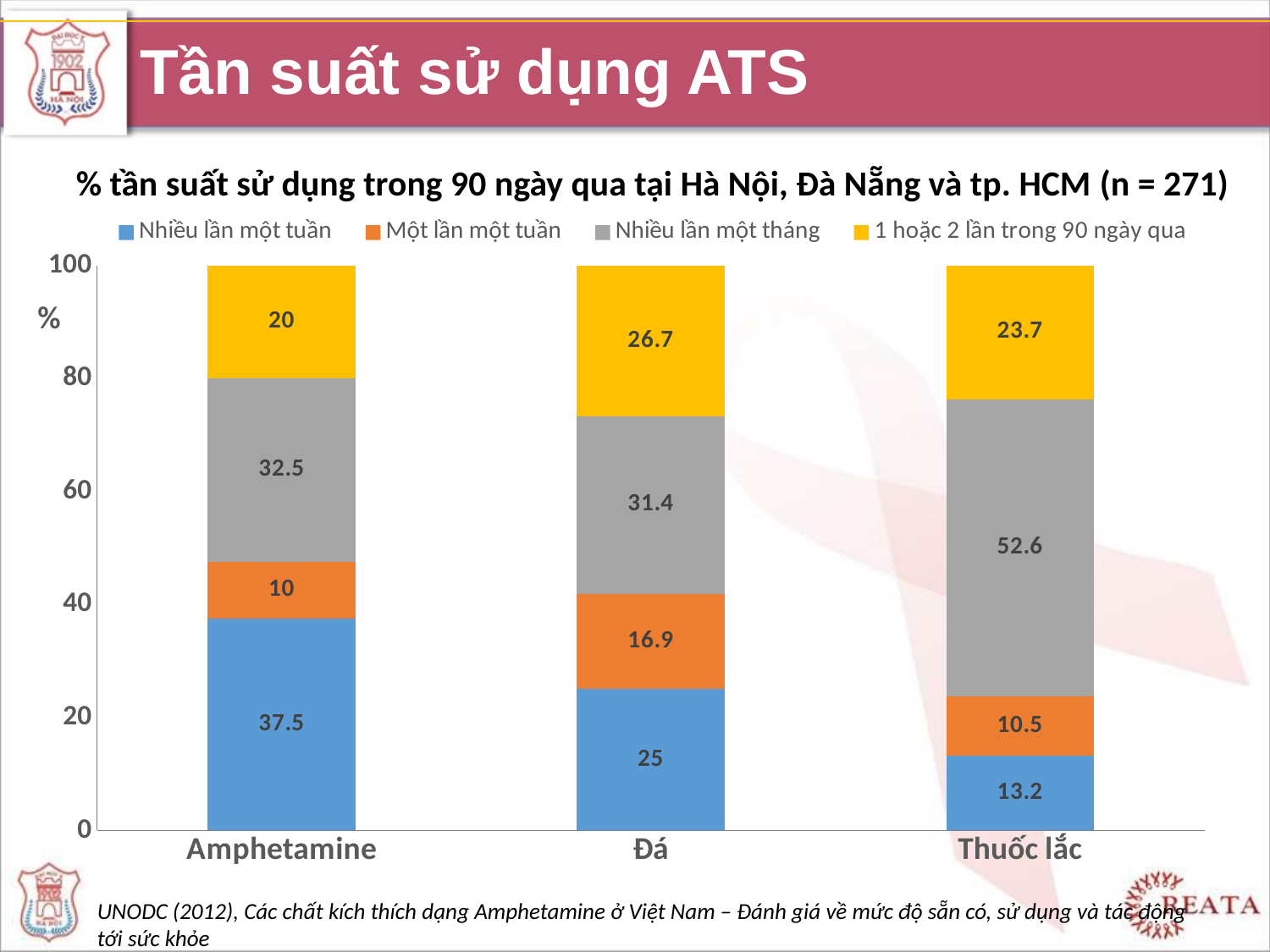
How many series does the legend list? 4 What is the value of "Nhiều lần một tuần" for Amphetamine? 37.5 Which category has the lowest value for "Nhiều lần một tháng"? Đá How many categories are shown on the x axis? 3 What is the value of "1 hoặc 2 lần trong 90 ngày qua" for Đá? 26.7 What is the total of the stacked bar for Đá? 100 Which is larger: "Một lần một tuần" for Đá or for Amphetamine? Đá What kind of chart is shown on the slide? Stacked bar chart What is the value of "Một lần một tuần" for Thuốc lắc? 10.5 What is the difference between the "Nhiều lần một tuần" values for Amphetamine and Thuốc lắc? 24.3 Which category has the highest value for "Nhiều lần một tuần"? Amphetamine What is the value of "Nhiều lần một tháng" for Thuốc lắc? 52.6